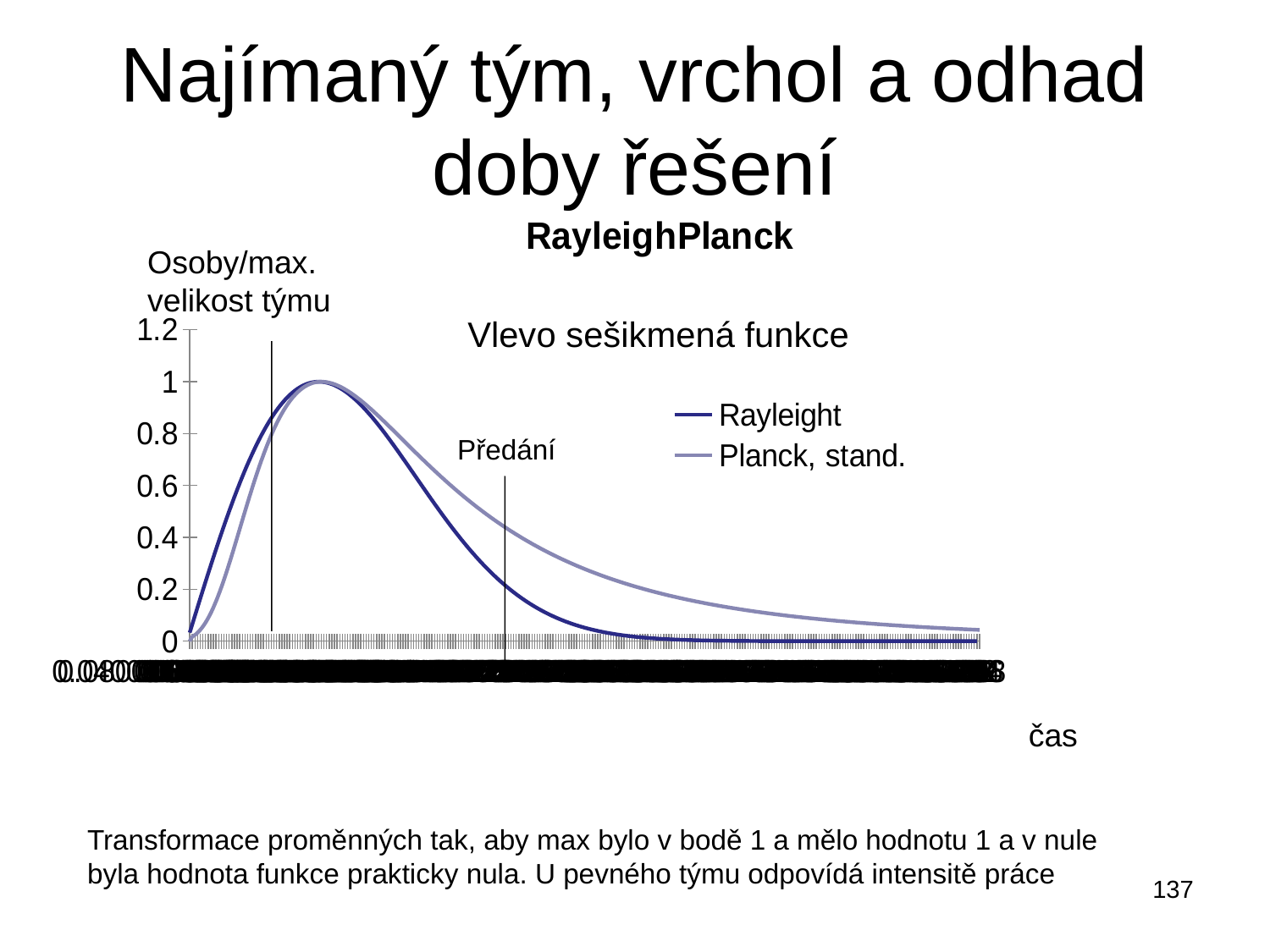
What is the title of the chart? RayleighPlanck How many series does the legend of the RayleighPlanck chart list? 2 What is the peak value reached by the Planck, stand. curve? 1 After reaching their peak, do the two curves rise or fall as the x axis (čas) increases? fall What are the two series named in the legend of the chart? Rayleight and Planck, stand. What is the peak value reached by the Rayleight curve? 1 At the right end of the x axis, is the value of the Planck, stand. curve greater or less than 0.2? less At the vertical line labelled Předání, is the value of the Planck, stand. curve greater or less than 0.2? greater What is the highest tick value shown on the y axis of the chart? 1.2 At the vertical line labelled Předání, which series has the larger value, Rayleight or Planck, stand.? Planck, stand. What kind of chart is shown on the slide? line chart At the vertical line labelled Předání, is the value of the Rayleight curve greater or less than 0.4? less